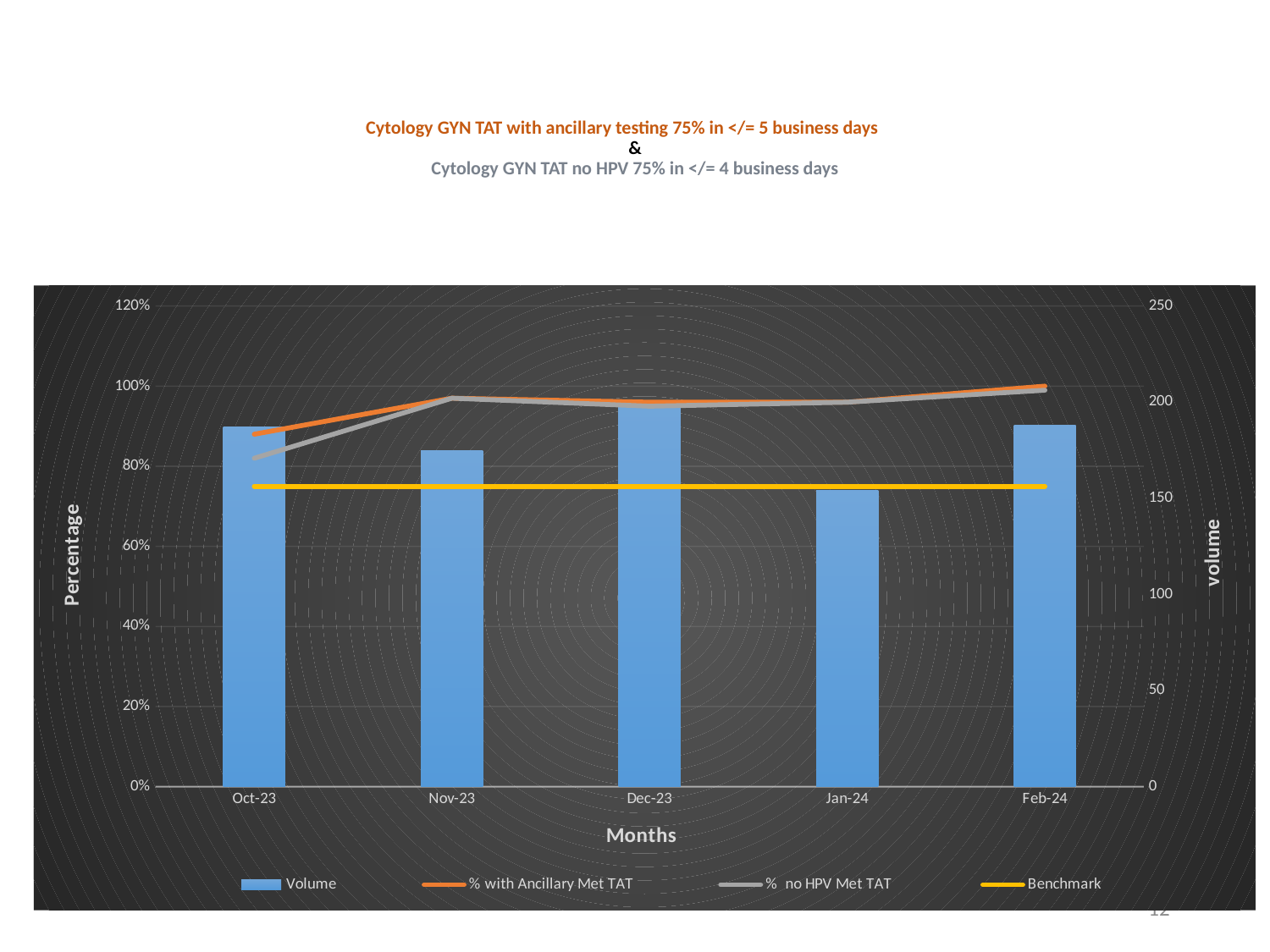
Which month has the highest Volume bar? Dec-23 Is the Volume for Dec-23 greater or less than 150? greater How many series does the chart legend list? 4 How many months are shown on the x axis of the chart? 5 Which month has the lowest Volume bar? Jan-24 What is the title of the left vertical axis of the chart? Percentage Is the % with Ancillary Met TAT value for Oct-23 greater or less than 80%? greater Is the Benchmark line greater or less than 80%? less Which month has the larger Volume, Oct-23 or Nov-23? Oct-23 What kind of chart is shown on the slide? A combination bar and line chart Does the % with Ancillary Met TAT line rise or fall from Oct-23 to Nov-23? rise